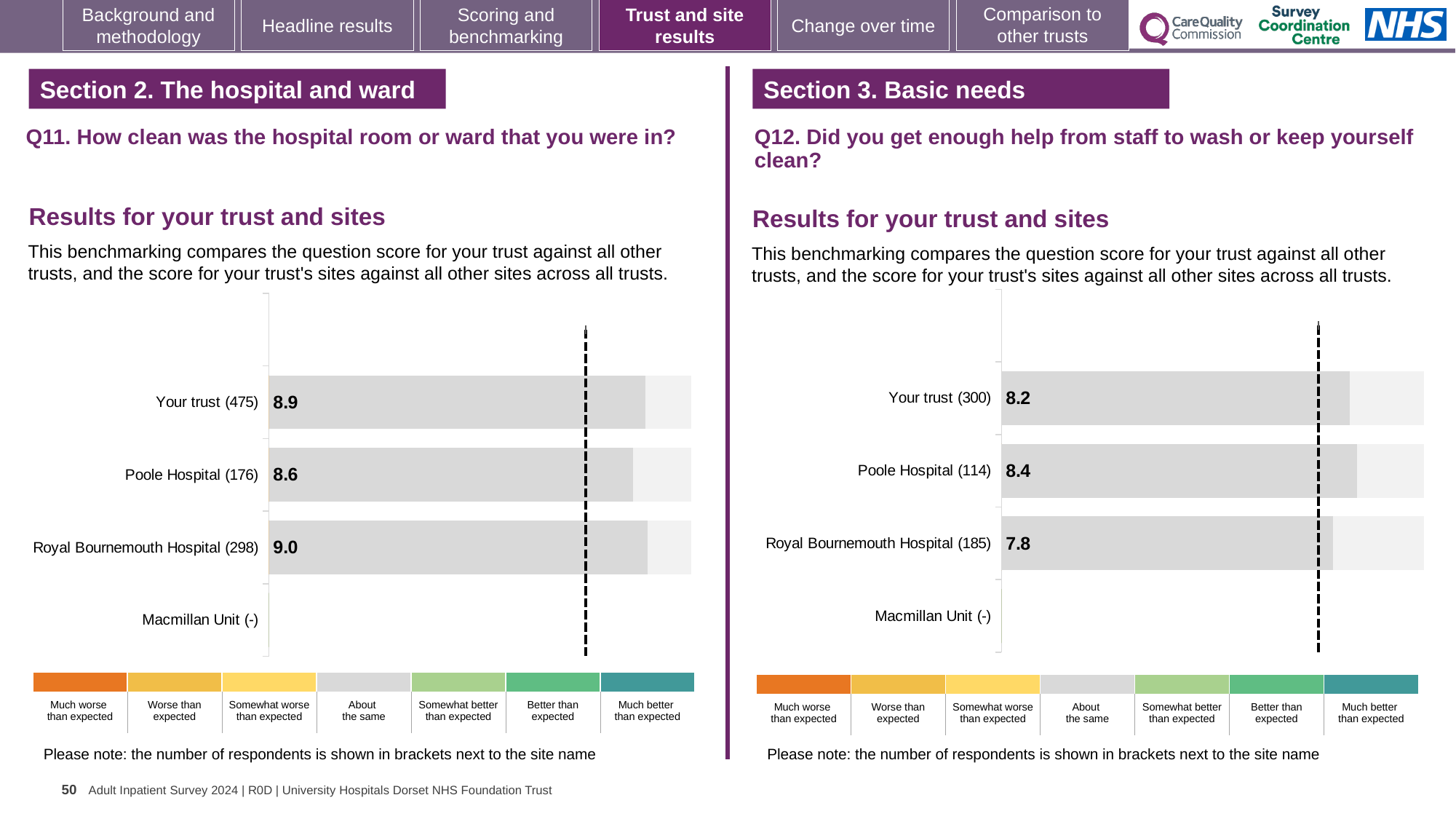
On the Q12 chart (right), what is the score for Royal Bournemouth Hospital? 7.8 On the Q12 chart (right), which site has the highest score? Poole Hospital On the Q11 chart (left), which site has the lowest score among those with a value shown? Poole Hospital On the Q12 chart (right), what is the difference between the scores for Your trust and Royal Bournemouth Hospital? 0.4 On the Q12 chart (right), what is the score for Poole Hospital? 8.4 On the Q11 chart (left), what is the difference between the scores for Royal Bournemouth Hospital and Poole Hospital? 0.4 On the Q11 chart (left), what is the score for Your trust? 8.9 On the Q12 chart (right), which has the larger score, Your trust or Poole Hospital? Poole Hospital What kind of chart is used on the Q11 chart (left)? Bar chart On the Q11 chart (left), what is the score for Royal Bournemouth Hospital? 9.0 How many site rows (including the trust) are listed on the Q12 chart (right)? 4 On the Q11 chart (left), how many respondents are shown in brackets for Your trust? 475